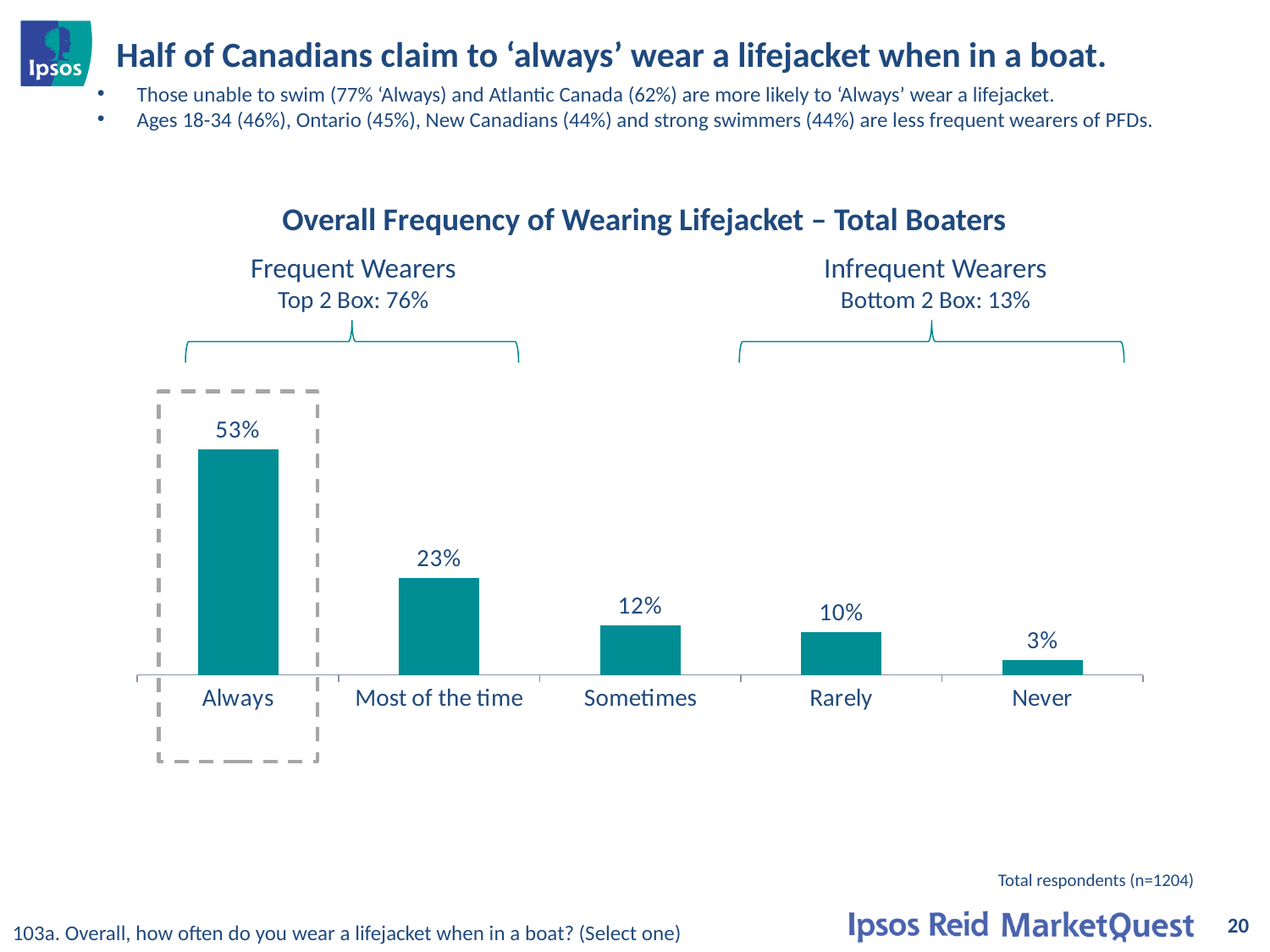
What kind of chart is shown on the slide? Bar chart Which category has the highest value? Always What is the value for 'Rarely'? 10% How many categories are shown on the x axis? 5 What is the difference between the 'Always' and 'Most of the time' values? 30% What percentage of boaters 'Never' wear a lifejacket? 3% Which is larger, the value for 'Sometimes' or the value for 'Rarely'? Sometimes What percentage of boaters say they 'Always' wear a lifejacket? 53% What is the value for 'Most of the time'? 23% What is the title of the chart? Overall Frequency of Wearing Lifejacket – Total Boaters Do the values rise or fall from left to right along the x axis? Fall Which category has the lowest value? Never